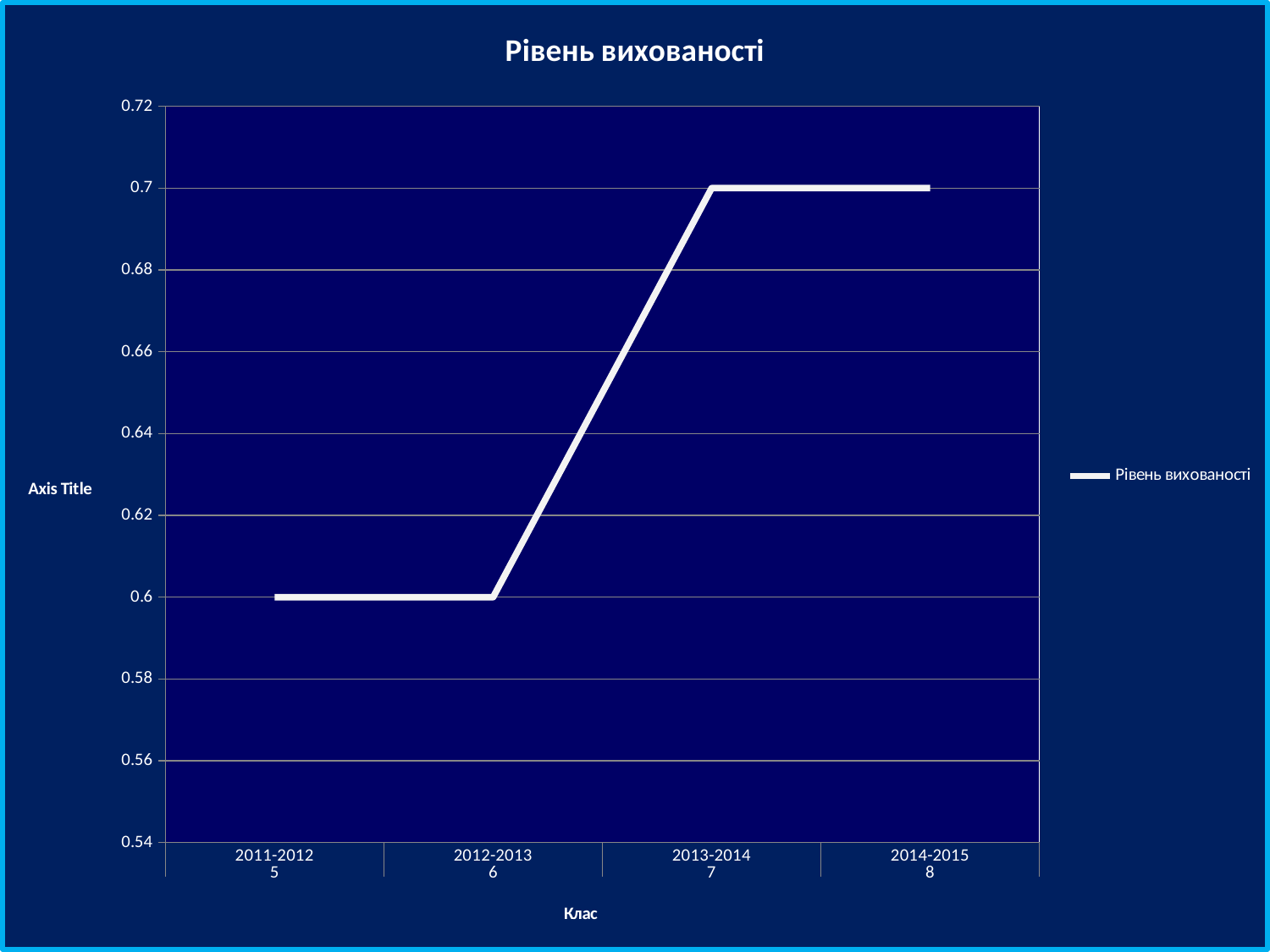
What type of chart is shown on the slide? line chart What is the label of the horizontal axis? Клас How many series does the legend list? 1 What is the difference between the value for 2013-2014 and the value for 2012-2013? 0.1 Which is larger, the value for 2012-2013 or the value for 2014-2015? 2014-2015 Do the values rise or fall from 2011-2012 to 2014-2015? rise Is the value for 2012-2013 greater or less than 0.64? less What is the value for 2013-2014 (class 7)? 0.7 How many data points are plotted on the line? 4 What is the value for 2014-2015 (class 8)? 0.7 What is the value for 2011-2012 (class 5)? 0.6 What is the title of the chart? Рівень вихованості